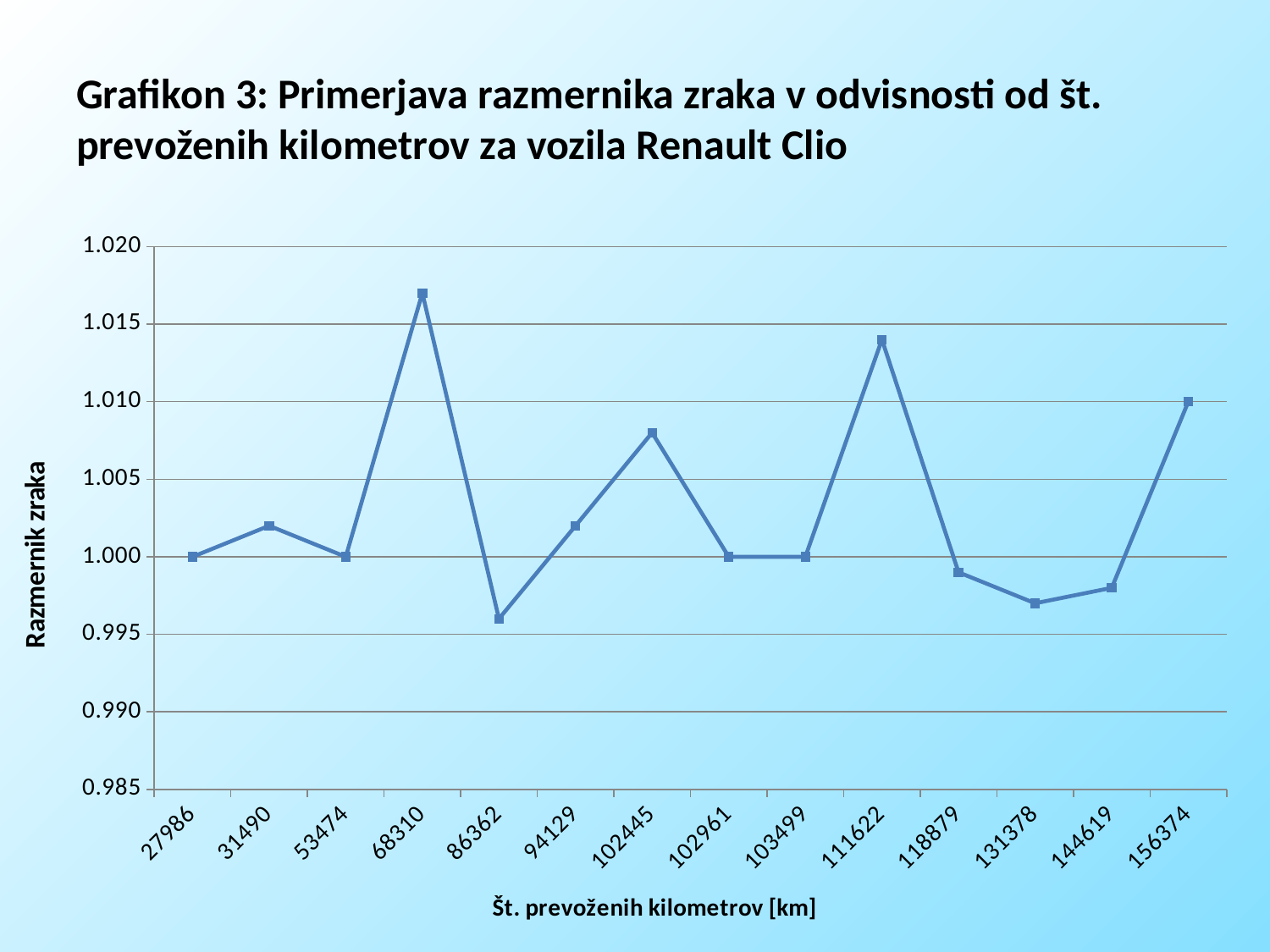
Does the value rise or fall from 68310 km to 86362 km? fall At which number of kilometres is the Razmernik zraka highest? 68310 What is the value of Razmernik zraka at 156374 km? 1.010 Is the value for 86362 km greater or less than 1.000? less Is the value for 68310 km greater or less than 1.015? greater How many data points are plotted on the chart? 14 What is the label of the vertical axis? Razmernik zraka Which has the larger Razmernik zraka value, 68310 km or 111622 km? 68310 What kind of chart is shown on the slide? line chart What is the value of Razmernik zraka at 27986 km? 1.000 What is the label of the horizontal axis? Št. prevoženih kilometrov [km] Is the value for 111622 km greater or less than 1.010? greater